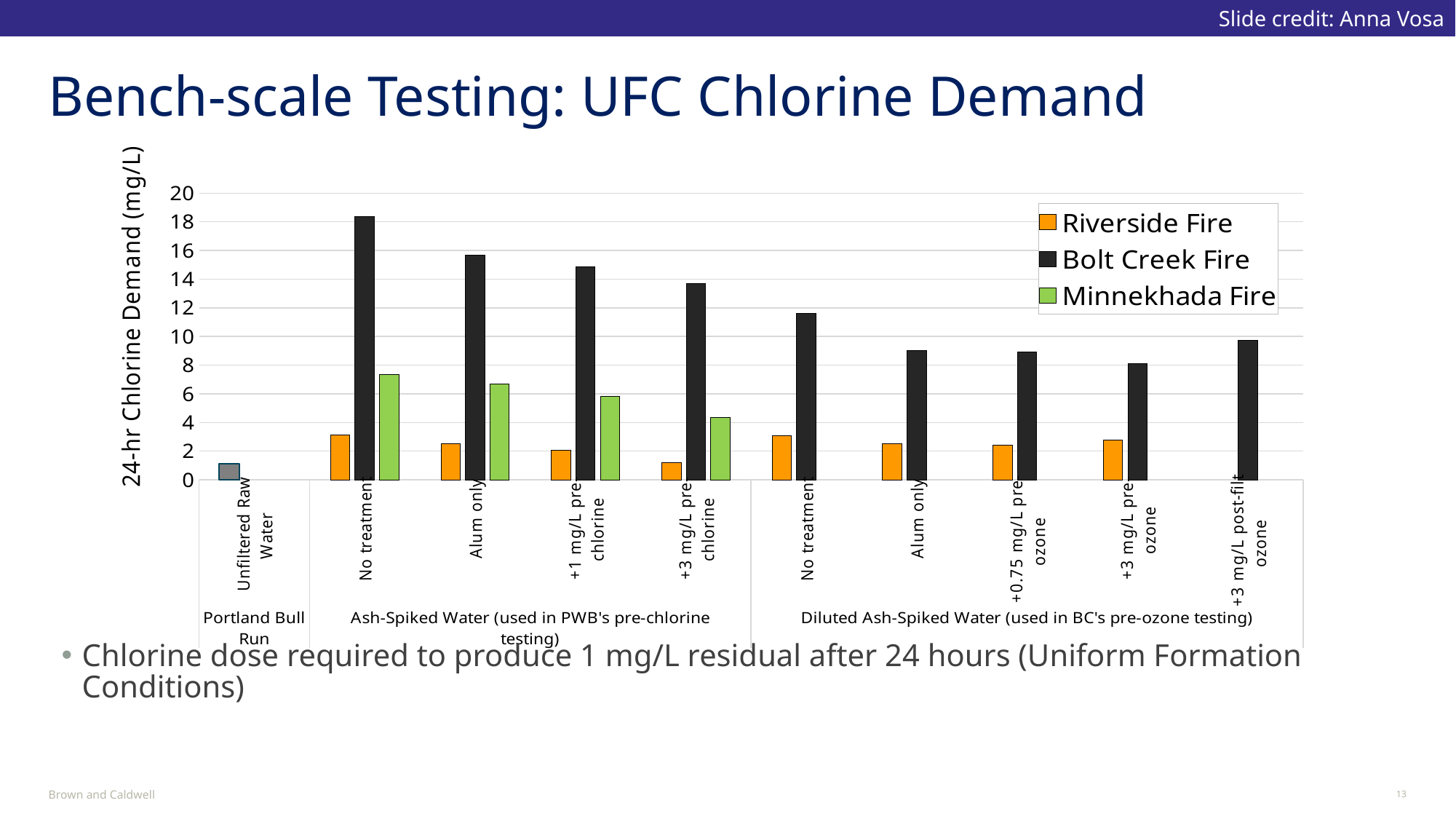
What is the label of the y axis? 24-hr Chlorine Demand (mg/L) Do the Minnekhada Fire values rise or fall across the Ash-Spiked Water treatments from 'No treatment' to '+3 mg/L pre-chlorine'? fall Which series has the highest chlorine demand for 'No treatment' in the Ash-Spiked Water group? Bolt Creek Fire Which series has the lowest chlorine demand for 'Alum only' in the Ash-Spiked Water group? Riverside Fire Is the Bolt Creek Fire value for '+3 mg/L pre-ozone' greater or less than 10? less Is the Bolt Creek Fire value for 'No treatment' in the Ash-Spiked Water group greater or less than 16? greater How many series does the legend list? 3 Which is larger: the Bolt Creek Fire value for 'Alum only' in the Ash-Spiked Water group or the Bolt Creek Fire value for 'Alum only' in the Diluted Ash-Spiked Water group? Ash-Spiked Water 'Alum only' What kind of chart is shown on the slide? bar chart Which series is shown in green in the legend? Minnekhada Fire Is the Minnekhada Fire value for '+3 mg/L pre-chlorine' greater or less than 6? less